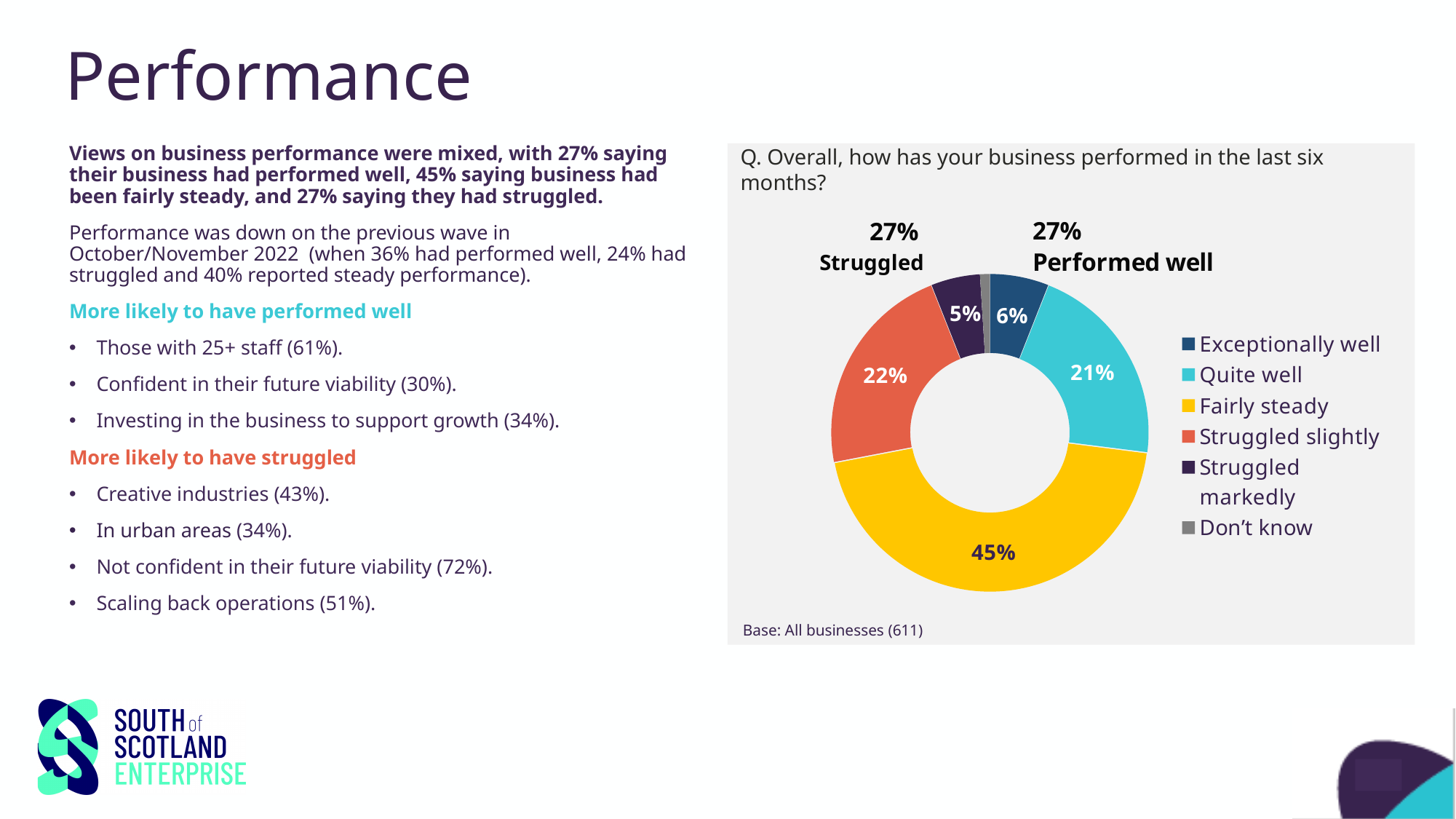
What percentage of businesses said they performed 'Quite well'? 21% How many categories does the legend of the donut chart list? 6 What is the difference between the 'Fairly steady' share and the 'Struggled slightly' share? 23 percentage points What kind of chart is shown on the slide? Donut (pie) chart What percentage of businesses said they performed 'Fairly steady'? 45% What is the base (number of respondents) shown beneath the chart? All businesses (611) Which is larger: the share for 'Quite well' or the share for 'Struggled slightly'? Struggled slightly What percentage of businesses said they 'Struggled slightly'? 22% Which labelled category has the smallest share of the donut chart? Struggled markedly What percentage of businesses said they performed 'Exceptionally well'? 6% Which category has the largest share of the donut chart? Fairly steady What percentage of businesses said they 'Struggled markedly'? 5%